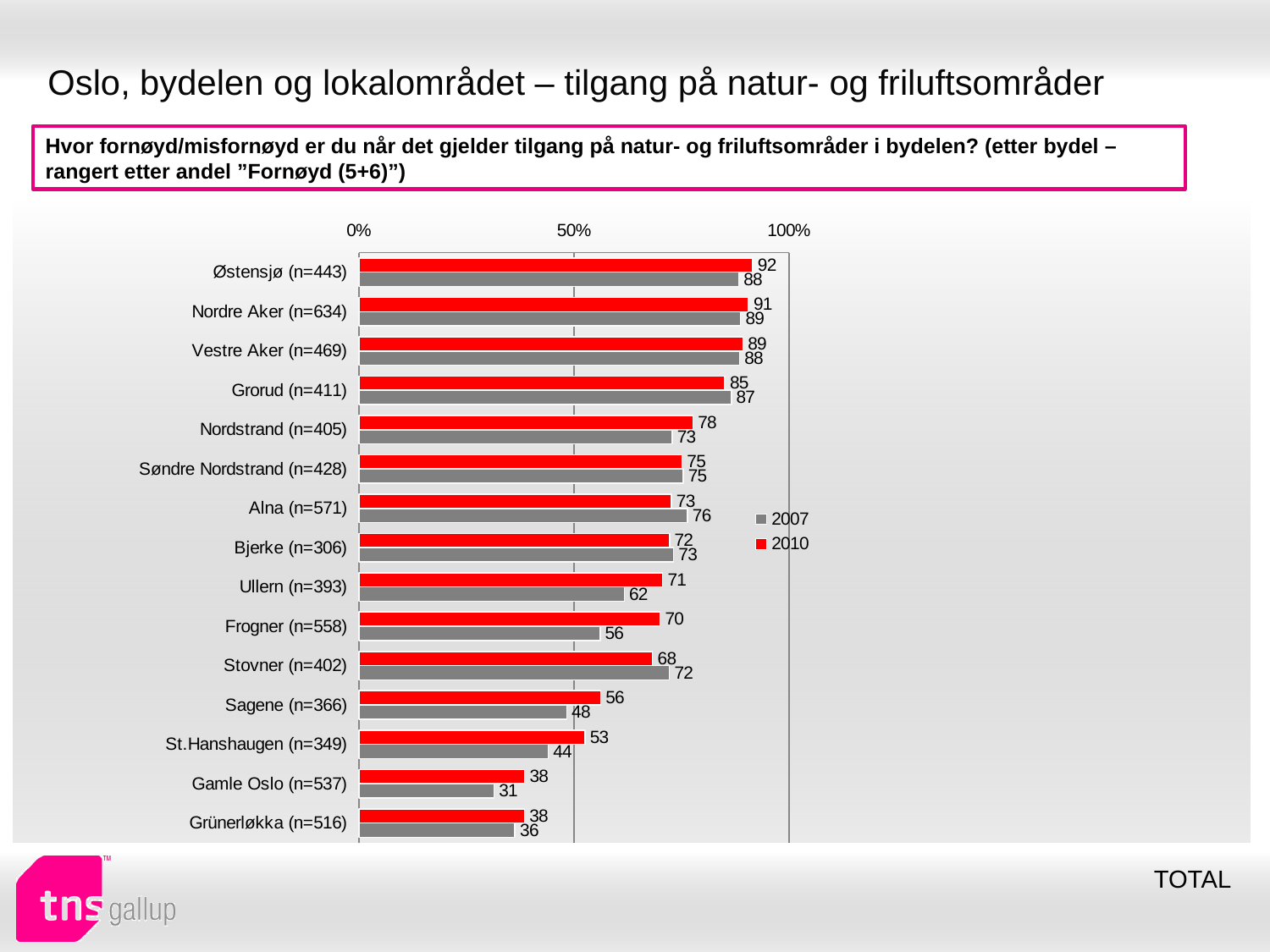
Which district has the lowest 2007 value? Gamle Oslo (n=537) What is the 2007 value for Frogner (n=558)? 56 Is the 2010 value for Sagene (n=366) greater or less than 50%? greater How many series does the legend list? 2 What kind of chart is shown on the slide? Bar chart What is the 2010 value for Østensjø (n=443)? 92 How many districts are shown on the chart? 15 What is the difference between the 2010 and 2007 values for Frogner (n=558)? 14 What is the 2007 value for Gamle Oslo (n=537)? 31 Which colour represents the 2010 series in the legend? Red Which is larger for Stovner (n=402), the 2007 value or the 2010 value? 2007 Which district has the highest 2010 value? Østensjø (n=443)